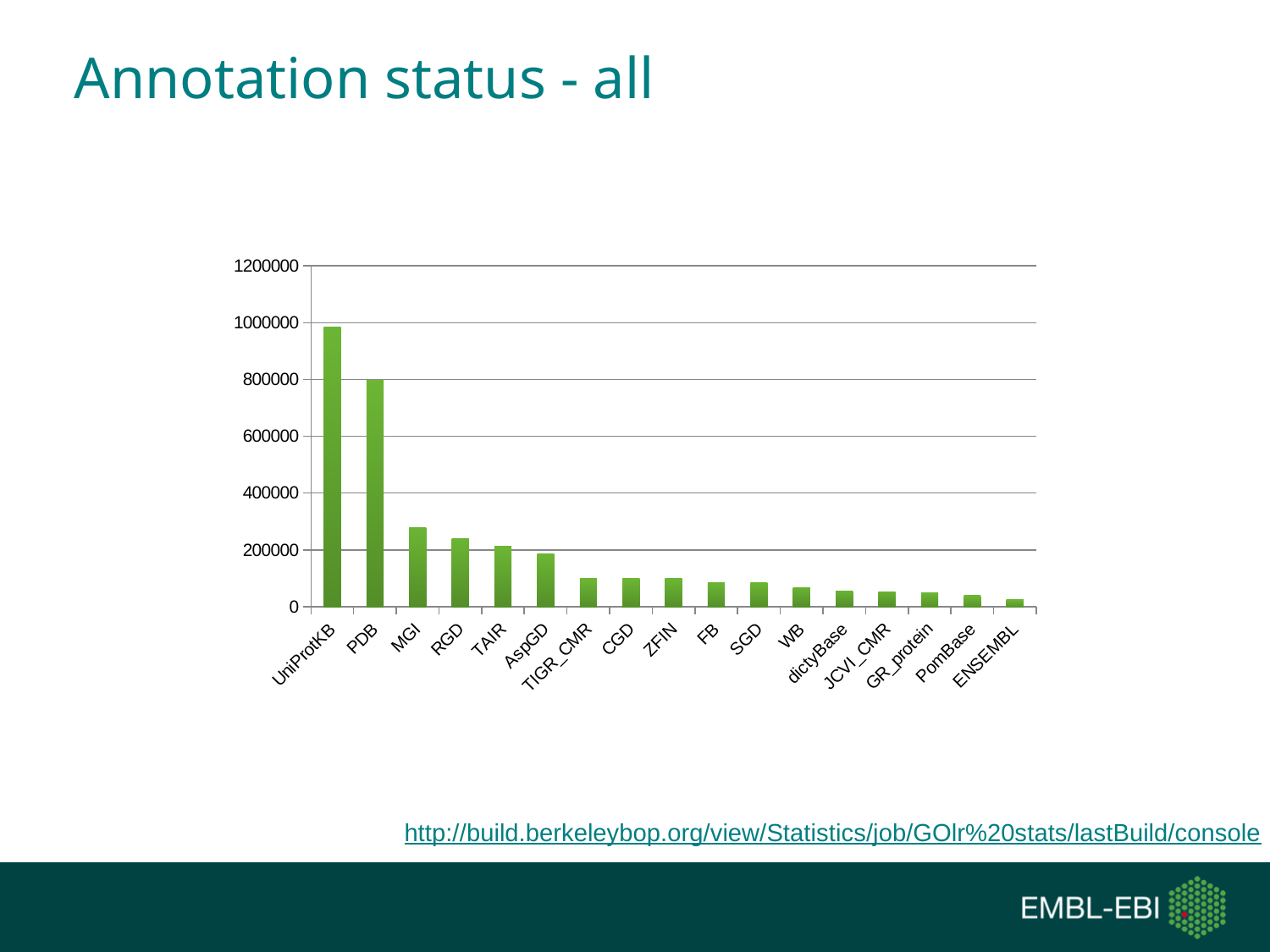
Is the value for UniProtKB greater or less than 800000? greater Which category has the highest value? UniProtKB Which category has the lowest value? ENSEMBL Is the value for MGI greater or less than 200000? greater Is the value for TIGR_CMR greater or less than 200000? less What is the title of the slide containing the chart? Annotation status - all Which is larger, the value for MGI or the value for RGD? MGI What kind of chart is shown on the slide? bar chart Do the values rise or fall moving from left to right along the x axis? fall How many categories are plotted along the x axis? 17